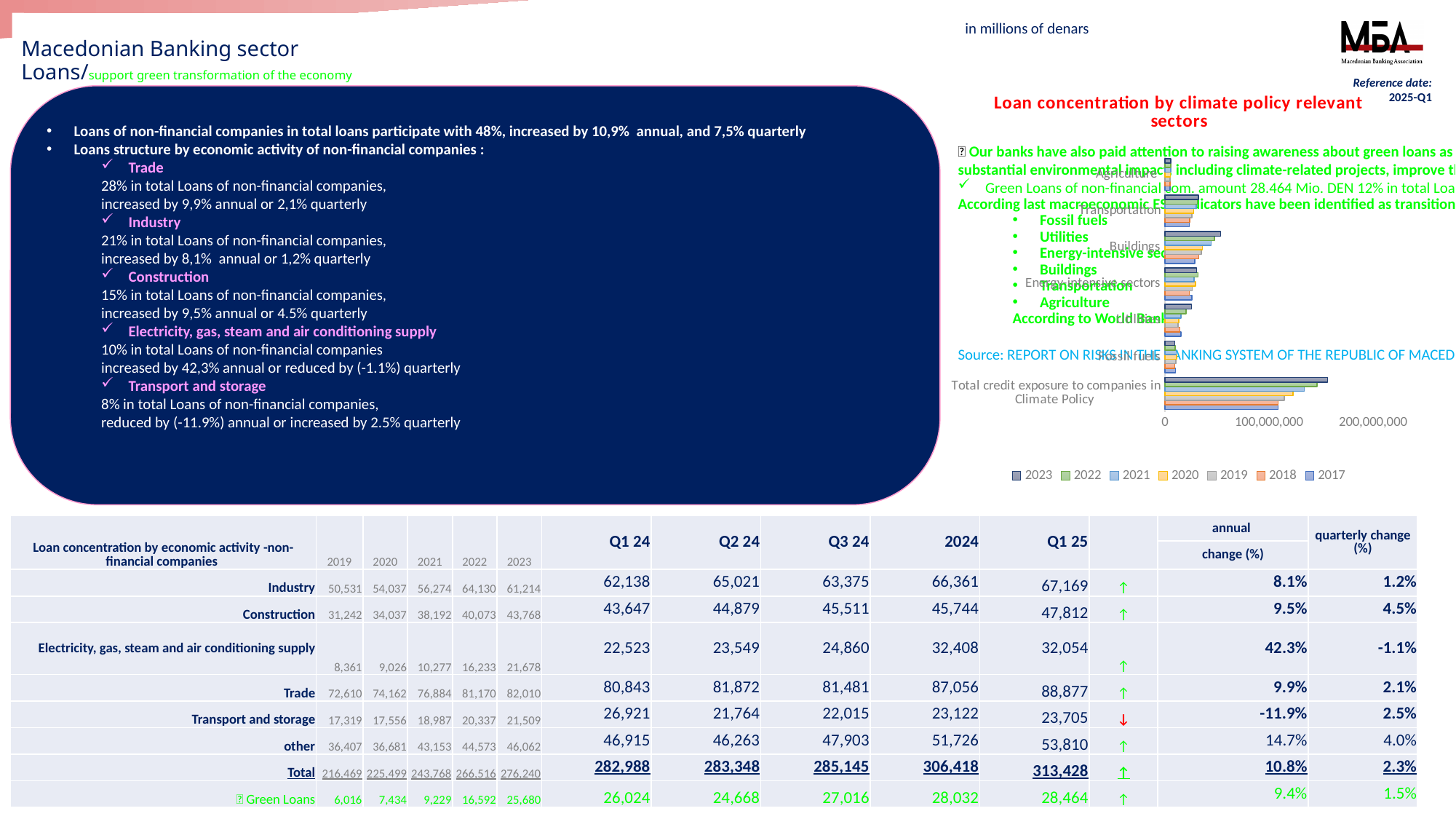
How many series does the legend of the 'Loan concentration by climate policy relevant sectors' chart list? 7 On the 'Loan concentration by climate policy relevant sectors' chart, which has the larger 2023 value: Total credit exposure to companies in Climate Policy or Utilities? Total credit exposure to companies in Climate Policy On the 'Loan concentration by climate policy relevant sectors' chart, is the 2023 value for Total credit exposure to companies in Climate Policy greater or less than 100,000,000? greater What kind of chart is the 'Loan concentration by climate policy relevant sectors' chart? bar chart Which year is listed first in the legend of the 'Loan concentration by climate policy relevant sectors' chart? 2023 On the 'Loan concentration by climate policy relevant sectors' chart, which has the larger 2023 value: Buildings or Fossil fuels? Buildings On the 'Loan concentration by climate policy relevant sectors' chart, is the 2023 value for Buildings greater or less than 100,000,000? less How many categories are shown on the 'Loan concentration by climate policy relevant sectors' chart? 7 Which category has the highest values on the 'Loan concentration by climate policy relevant sectors' chart? Total credit exposure to companies in Climate Policy On the 'Loan concentration by climate policy relevant sectors' chart, is the 2023 value for Agriculture greater or less than 100,000,000? less What is the highest tick value shown on the value axis of the 'Loan concentration by climate policy relevant sectors' chart? 200,000,000